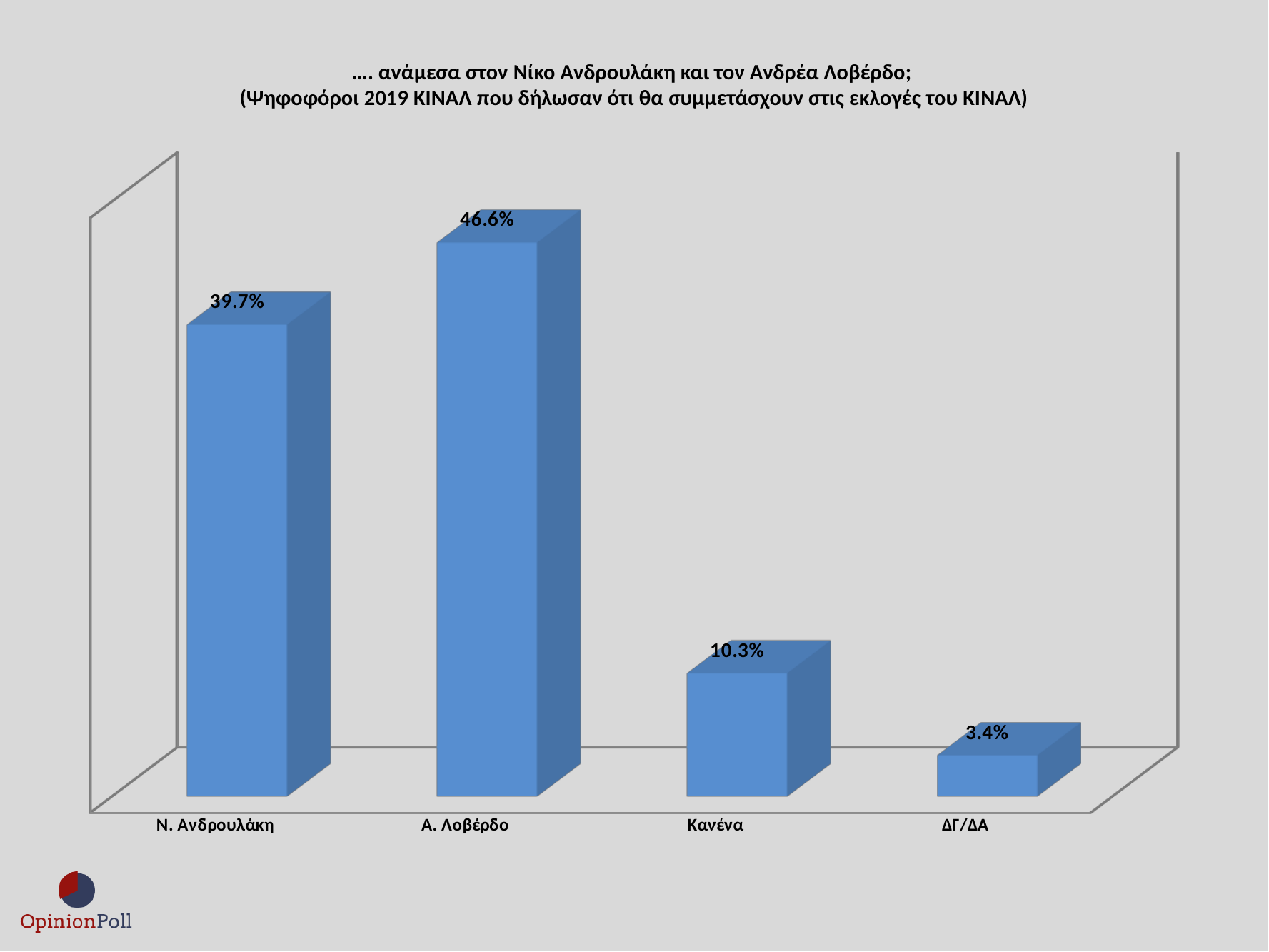
What colour are the bars in the chart? Blue Which category has the lowest value? ΔΓ/ΔΑ What is the value for Α. Λοβέρδο? 46.6% What is the value for Ν. Ανδρουλάκη? 39.7% How many categories are shown on the x axis? 4 What is the value for ΔΓ/ΔΑ? 3.4% What is the difference between the values for Κανένα and ΔΓ/ΔΑ? 6.9% What is the difference between the values for Α. Λοβέρδο and Ν. Ανδρουλάκη? 6.9% What is the value for Κανένα? 10.3% Which is larger, the value for Ν. Ανδρουλάκη or the value for Κανένα? Ν. Ανδρουλάκη What kind of chart is shown on the slide? Bar chart Which category has the highest value? Α. Λοβέρδο